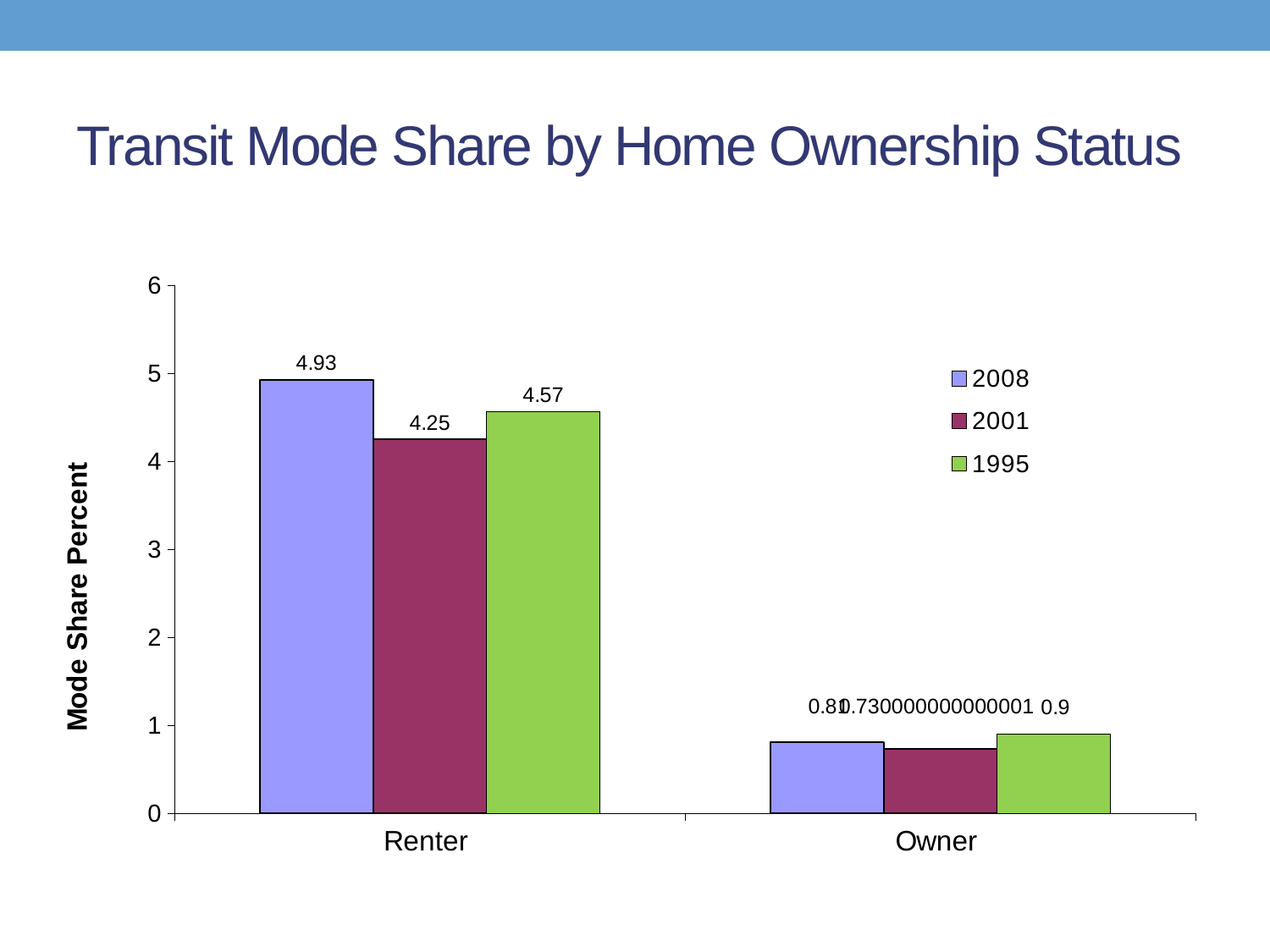
What is the value for Owner in the 1995 series? 0.9 For the Renter category, which series has the highest value? 2008 How many categories are shown on the x axis? 2 What is the difference between the 2008 and 2001 values for Renter? 0.68 Is the value for Owner in the 2008 series greater or less than 1? less For the Renter category, which series has the lowest value? 2001 How many series does the legend list? 3 What is the value for Renter in the 2001 series? 4.25 What is the value for Renter in the 1995 series? 4.57 In the 1995 series, which category has the larger value, Renter or Owner? Renter What is the value for Renter in the 2008 series? 4.93 What kind of chart is shown on the slide? bar chart